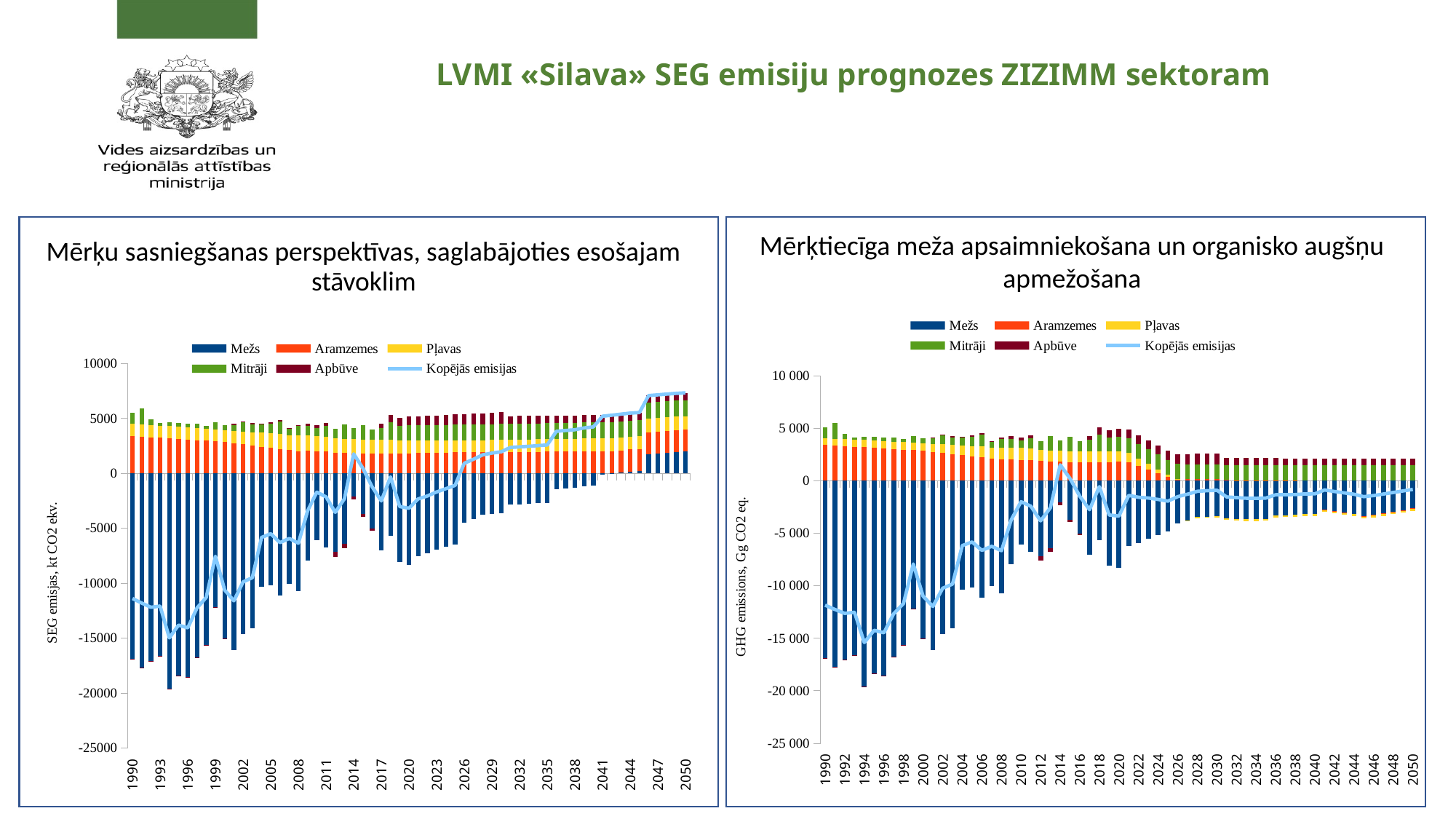
How many series does the legend of the right chart, "Mērķtiecīga meža apsaimniekošana un organisko augšņu apmežošana", list? 6 In the right chart, is the Kopējās emisijas value for 2050 greater or less than 0? less In the left chart, is the Kopējās emisijas value for 1990 greater or less than -10000? less In the left chart, which is larger: the Kopējās emisijas value for 2050 or for 1990? 2050 In the left chart, does the Kopējās emisijas line overall rise or fall from 1990 to 2050? rise What is the y-axis label of the right chart? GHG emissions, Gg CO2 eq. What kind of chart is the left chart, titled "Mērķu sasniegšanas perspektīvas, saglabājoties esošajam stāvoklim"? Stacked bar chart with a line In the right chart, is the Mežs value for 1994 greater or less than -15 000? less In the right chart, does the Kopējās emisijas line overall rise or fall from 1990 to 2050? rise In the right chart, in which year is the Mežs bar lowest? 1994 In the left chart, which series is drawn as a light blue line rather than bars? Kopējās emisijas